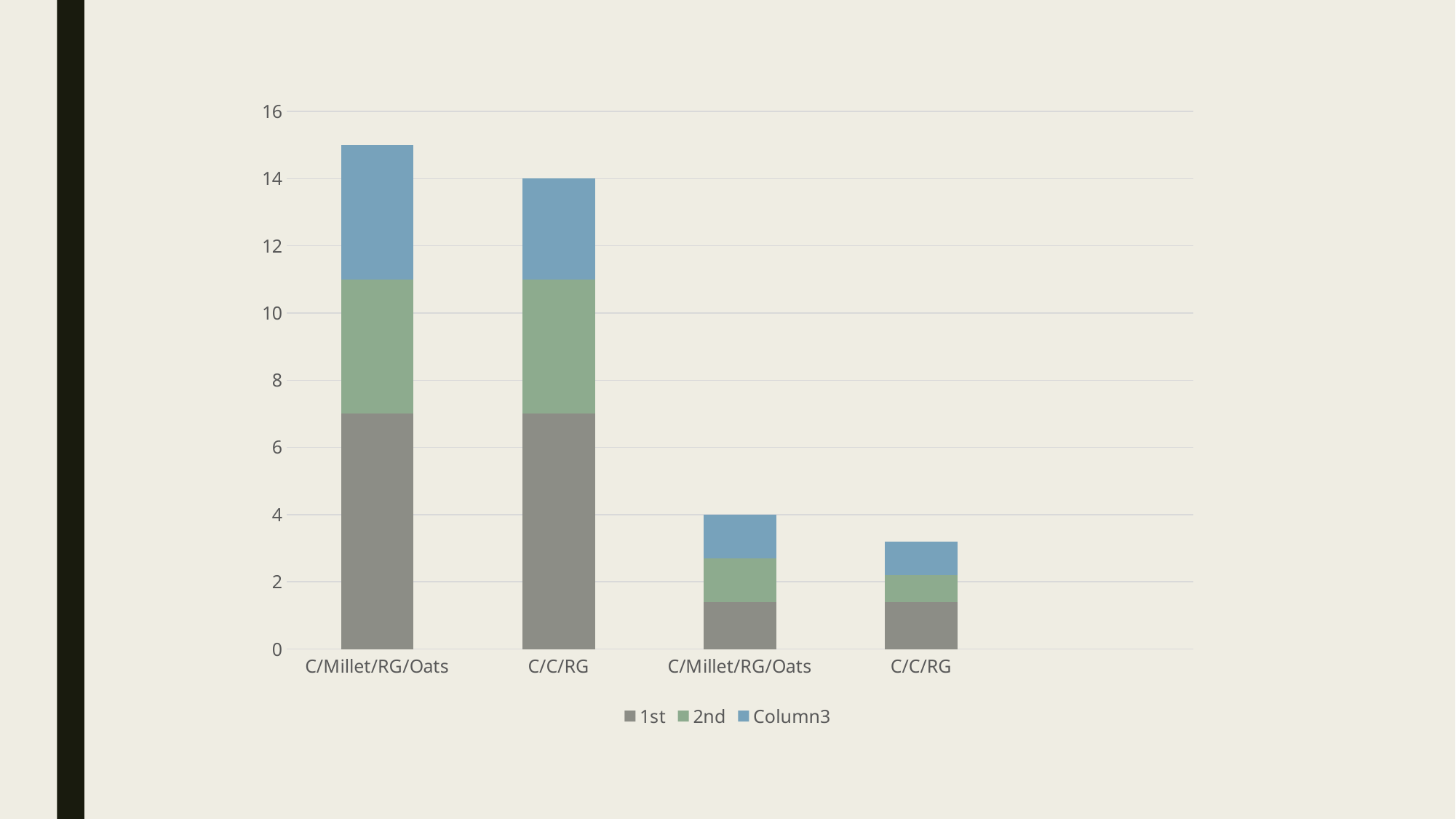
What kind of chart is shown on the slide? Stacked bar chart What is the total height of the second bar from the left (C/C/RG)? 14 How many bars are plotted in the chart? 4 Which bar is the shortest overall? The rightmost C/C/RG bar How many series does the legend list? 3 What is the total height of the third bar from the left (C/Millet/RG/Oats)? 4 Is the total of the rightmost bar greater or less than 4? less Which colour represents the Column3 series? Blue What are the three series named in the legend? 1st, 2nd, Column3 Is the total of the leftmost bar greater or less than 14? greater Which bar is the tallest overall? The leftmost C/Millet/RG/Oats bar Do the bar totals rise or fall moving from left to right along the x axis? Fall